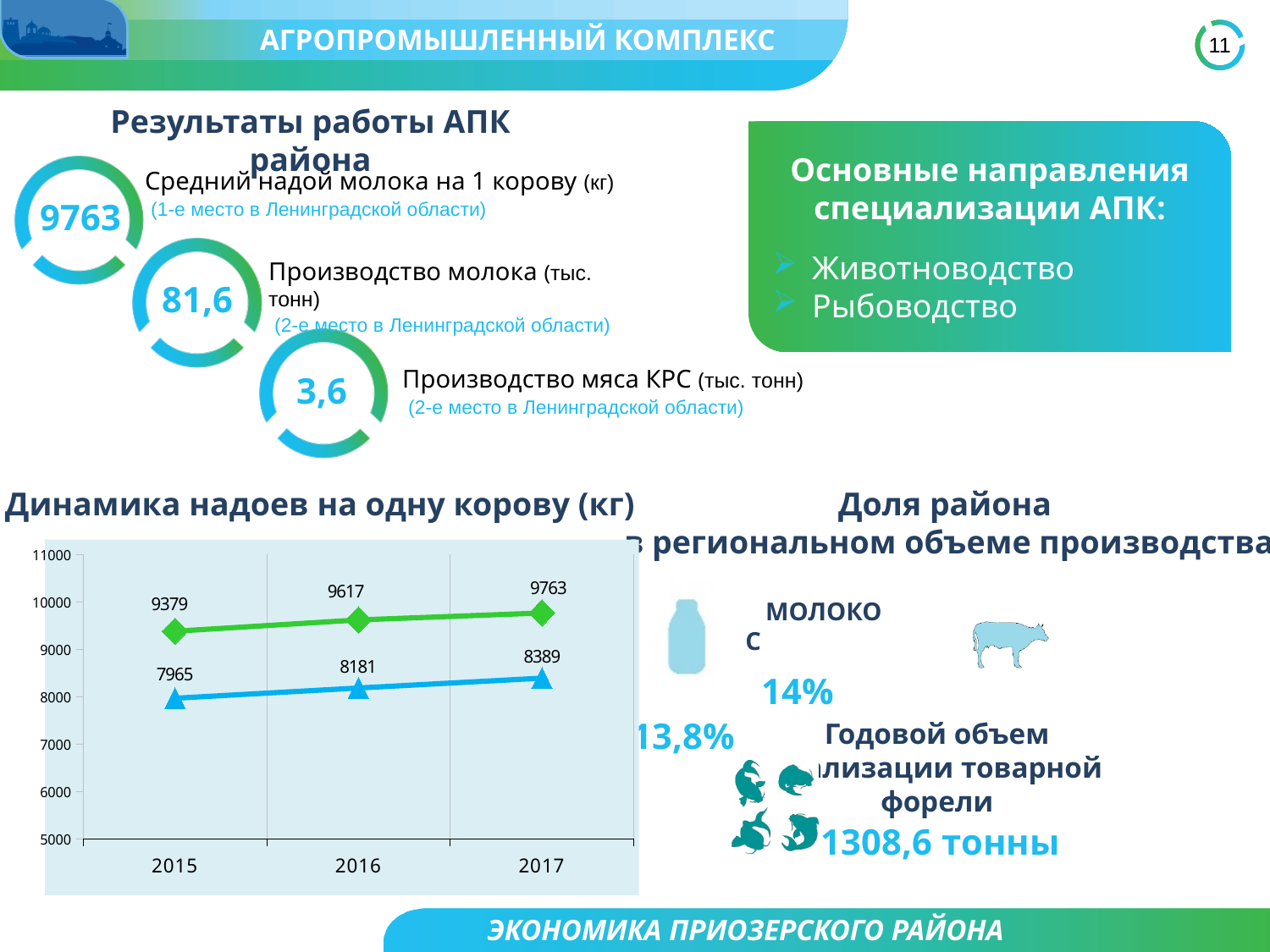
In the chart "Динамика надоев на одну корову (кг)", do the values of the blue line rise or fall from 2015 to 2017? rise In the chart "Динамика надоев на одну корову (кг)", what is the difference between the green line and the blue line in 2016? 1436 In the chart "Динамика надоев на одну корову (кг)", which is larger in 2015: the green line value or the blue line value? the green line value In the chart "Динамика надоев на одну корову (кг)", by how much did the green line increase from 2015 to 2017? 384 In the chart "Динамика надоев на одну корову (кг)", what is the value of the blue line for 2017? 8389 In the chart "Динамика надоев на одну корову (кг)", what is the value of the green line for 2016? 9617 How many years are shown on the x axis of the chart "Динамика надоев на одну корову (кг)"? 3 In the chart "Динамика надоев на одну корову (кг)", what is the value of the green line (diamond markers) for 2017? 9763 In the chart "Динамика надоев на одну корову (кг)", what is the value of the blue line (triangle markers) for 2015? 7965 In the chart "Динамика надоев на одну корову (кг)", which year has the lowest value on the blue line? 2015 What kind of chart is "Динамика надоев на одну корову (кг)"? line chart In the chart "Динамика надоев на одну корову (кг)", which year has the highest value on the green line? 2017